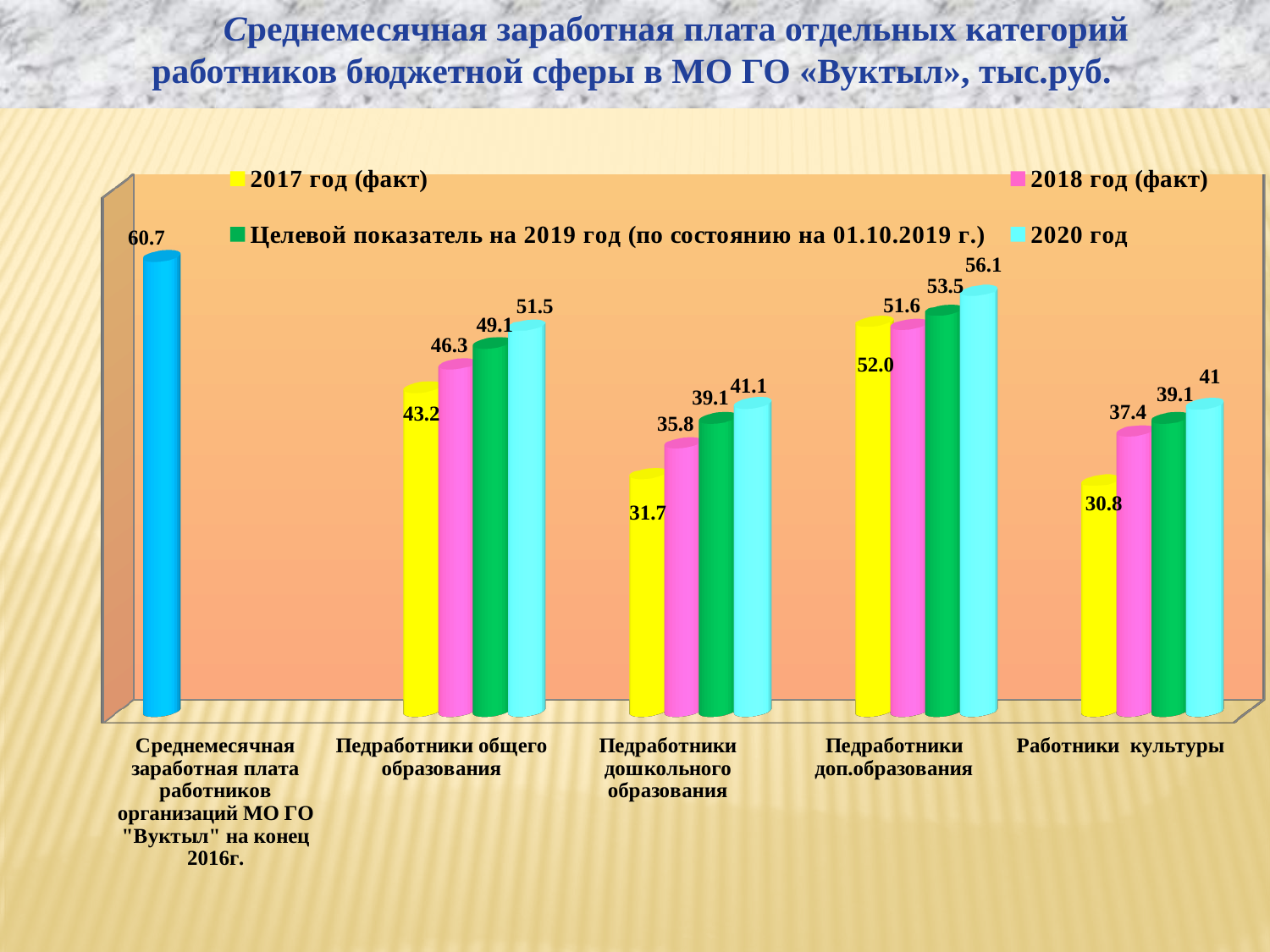
Which category has the lowest value for 2017 год (факт)? Работники культуры How many series does the legend list? 4 What is the value for Педработники общего образования in 2017 год (факт)? 43.2 Which category has the highest value for 2020 год? Педработники доп.образования Which is larger for Педработники доп.образования: the 2017 год (факт) value or the 2018 год (факт) value? 2017 год (факт) What type of chart is shown on the slide? bar chart What is the value for Педработники дошкольного образования in 2020 год? 41.1 What is the value for Педработники доп.образования in Целевой показатель на 2019 год (по состоянию на 01.10.2019 г.)? 53.5 What is the value for Работники культуры in 2018 год (факт)? 37.4 Do the values for Работники культуры rise or fall from 2017 год (факт) to 2020 год? rise What is the difference between the 2020 год and 2017 год (факт) values for Педработники дошкольного образования? 9.4 What is the value of the single bar for Среднемесячная заработная плата работников организаций МО ГО "Вуктыл" на конец 2016г.? 60.7